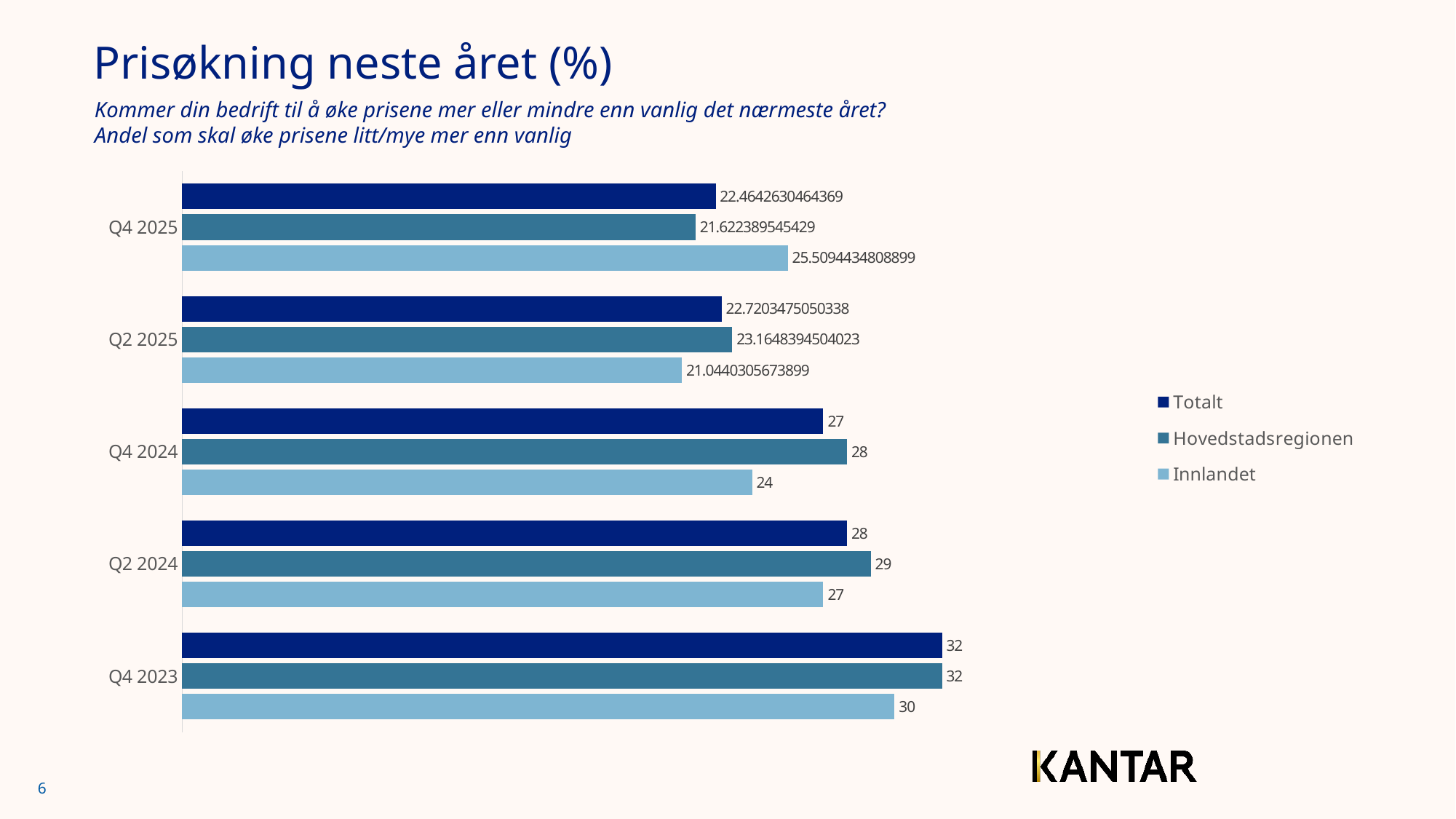
How many quarters are shown on the chart? 5 What is the value for Totalt in Q4 2024? 27 Which is larger in Q2 2024: Totalt or Innlandet? Totalt Which quarter has the highest value for Totalt? Q4 2023 Which quarter has the lowest value for Innlandet? Q2 2025 What is the value for Hovedstadsregionen in Q2 2024? 29 What is the difference between Hovedstadsregionen and Innlandet in Q4 2024? 4 Which series is shown in the lightest blue colour in the legend? Innlandet What kind of chart is shown on the slide? Bar chart How many series does the legend list? 3 What is the value for Innlandet in Q4 2025? 25.5094434808899 What is the value for Innlandet in Q4 2023? 30